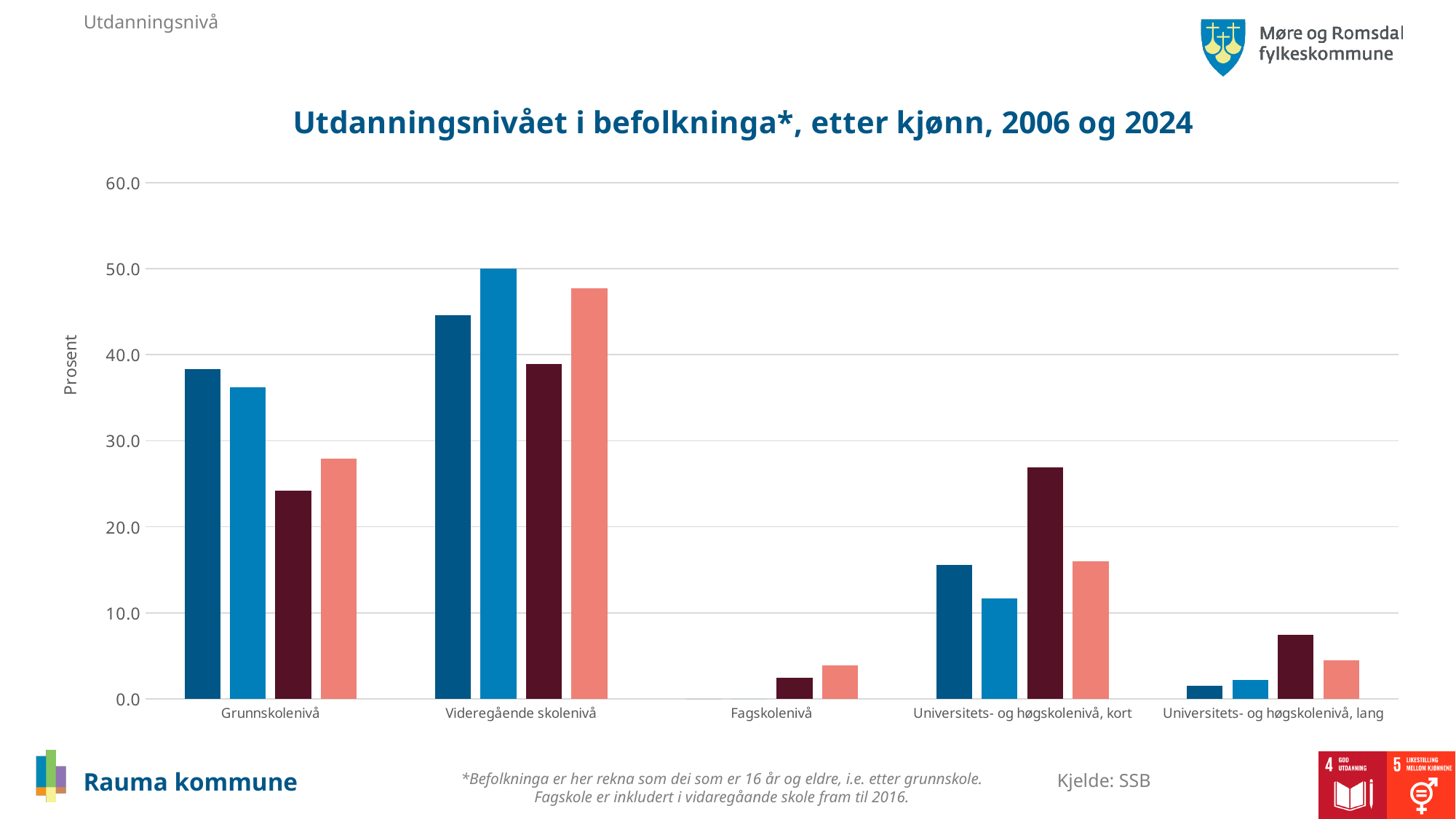
Is the third (dark red) bar for Universitets- og høgskolenivå, kort greater or less than 20? greater What kind of chart is shown on the slide? bar chart Is the last (salmon) bar for Universitets- og høgskolenivå, lang greater or less than 10? less What is the title of the chart? Utdanningsnivået i befolkninga*, etter kjønn, 2006 og 2024 Is the first (dark blue) bar for Grunnskolenivå greater or less than 30? greater What is the label on the y axis? Prosent Which category has the tallest bars overall? Videregående skolenivå Which category has the lowest values overall? Fagskolenivå Which is larger: the first (dark blue) bar for Grunnskolenivå or the first (dark blue) bar for Videregående skolenivå? Videregående skolenivå How many education-level categories are shown on the x axis? 5